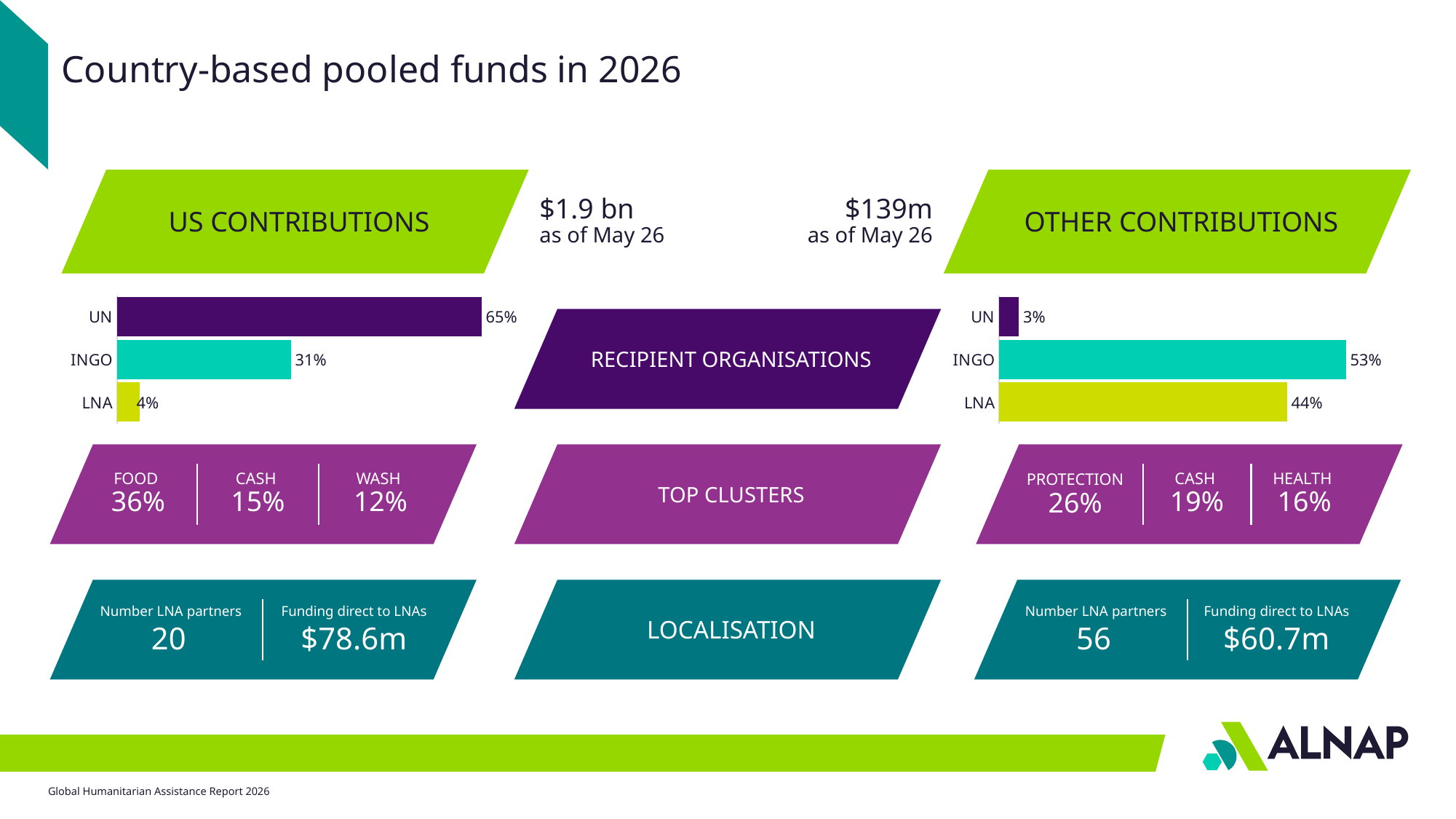
In the Other Contributions recipient organisations chart, what is the difference between the INGO share and the LNA share? 9% In the US Contributions recipient organisations chart, what share goes to UN? 65% In the Other Contributions recipient organisations chart, what colour is the INGO bar? Teal In the Other Contributions recipient organisations chart, what share goes to UN? 3% In the US Contributions recipient organisations chart, what share goes to INGO? 31% In the US Contributions recipient organisations chart, what is the difference between the UN share and the INGO share? 34% In the US Contributions recipient organisations chart, which recipient type has the highest share? UN In the Other Contributions recipient organisations chart, what share goes to LNA? 44% Which is larger: the LNA share in the US Contributions chart or the LNA share in the Other Contributions chart? Other Contributions How many recipient organisation categories are shown in the US Contributions bar chart? 3 In the Other Contributions recipient organisations chart, which recipient type has the lowest share? UN What kind of chart is used to show recipient organisations under US Contributions? Bar chart